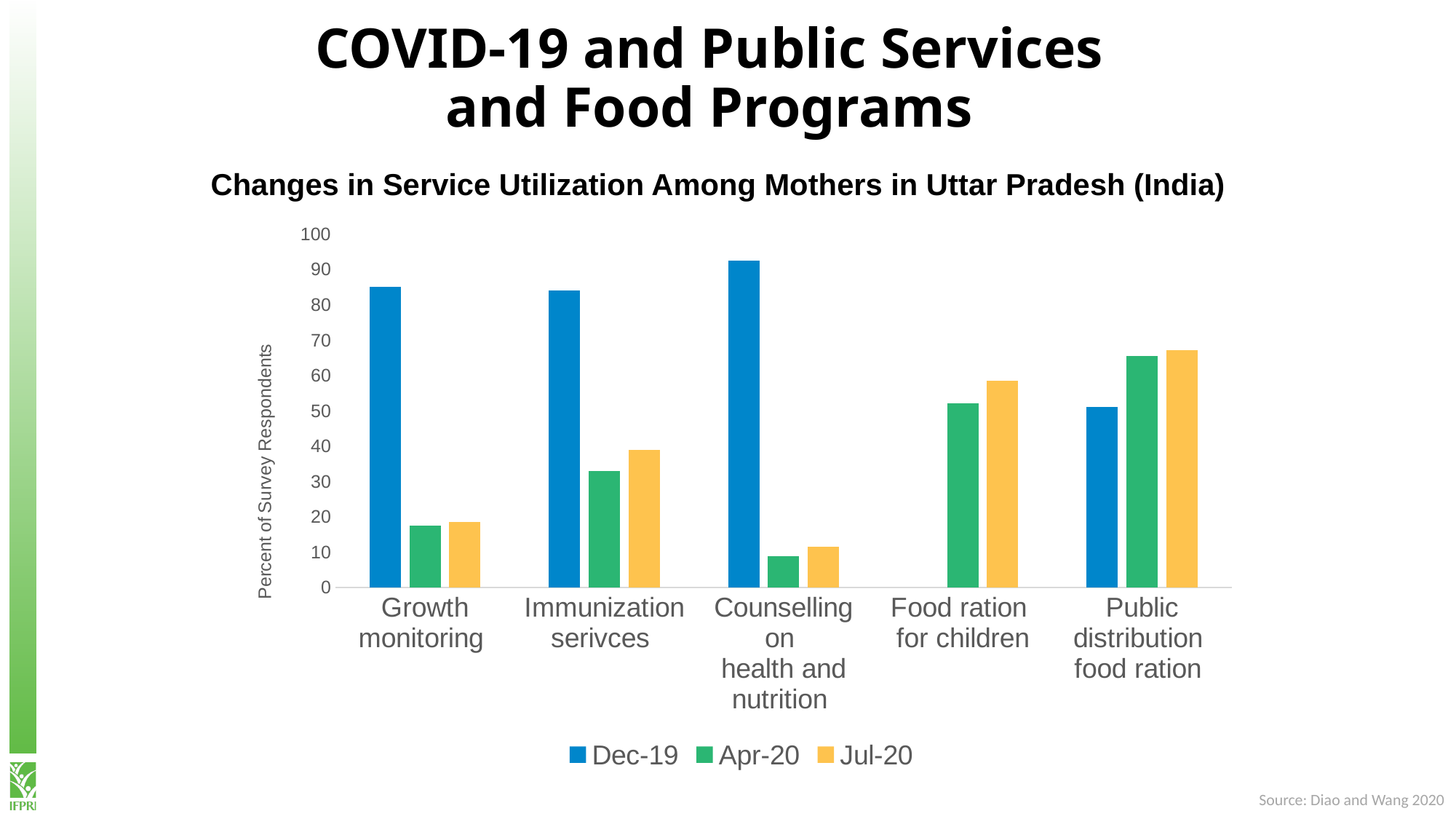
What kind of chart is shown on the slide? Bar chart Is the Apr-20 value for Immunization serivces greater or less than 40? less Which category has the highest Jul-20 value? Public distribution food ration Is the Dec-19 value for Public distribution food ration greater or less than 60? less How many series does the legend list? 3 Which is larger: the Jul-20 value for Food ration for children or the Jul-20 value for Growth monitoring? Food ration for children Is the Dec-19 value for Growth monitoring greater or less than 80? greater How many service categories are shown on the x axis? 5 What is the label on the y axis? Percent of Survey Respondents Which category has the lowest Apr-20 value? Counselling on health and nutrition Which category has the highest Dec-19 value? Counselling on health and nutrition